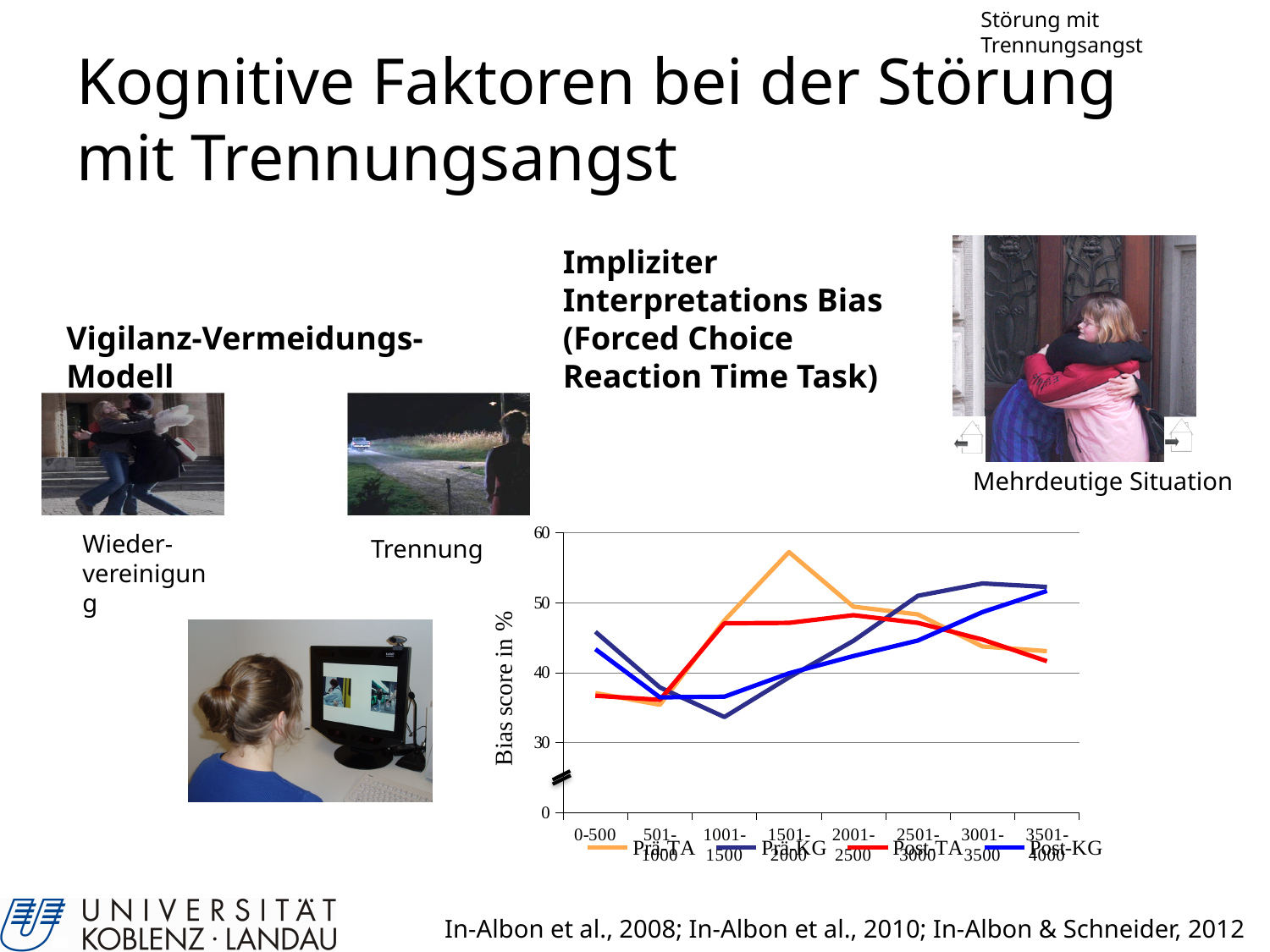
Which series is drawn in red in the chart? Post-TA At 3501-4000, which series has the larger value, Prä-KG or Post-TA? Prä-KG Is the value for Prä-TA at 1501-2000 greater or less than 50? greater Is the value for Prä-KG at 1001-1500 greater or less than 40? less At which x-axis interval does the Prä-KG series reach its lowest value? 1001-1500 What kind of chart is shown on the slide? line chart At 1501-2000, which series has the larger value, Prä-TA or Post-KG? Prä-TA What is the title of the chart's y axis? Bias score in % How many time-interval categories are shown on the x axis of the chart? 8 Does the Post-KG series rise or fall from 1001-1500 to 3501-4000? rise At which x-axis interval does the Prä-TA series reach its highest value? 1501-2000 How many series does the chart's legend list? 4